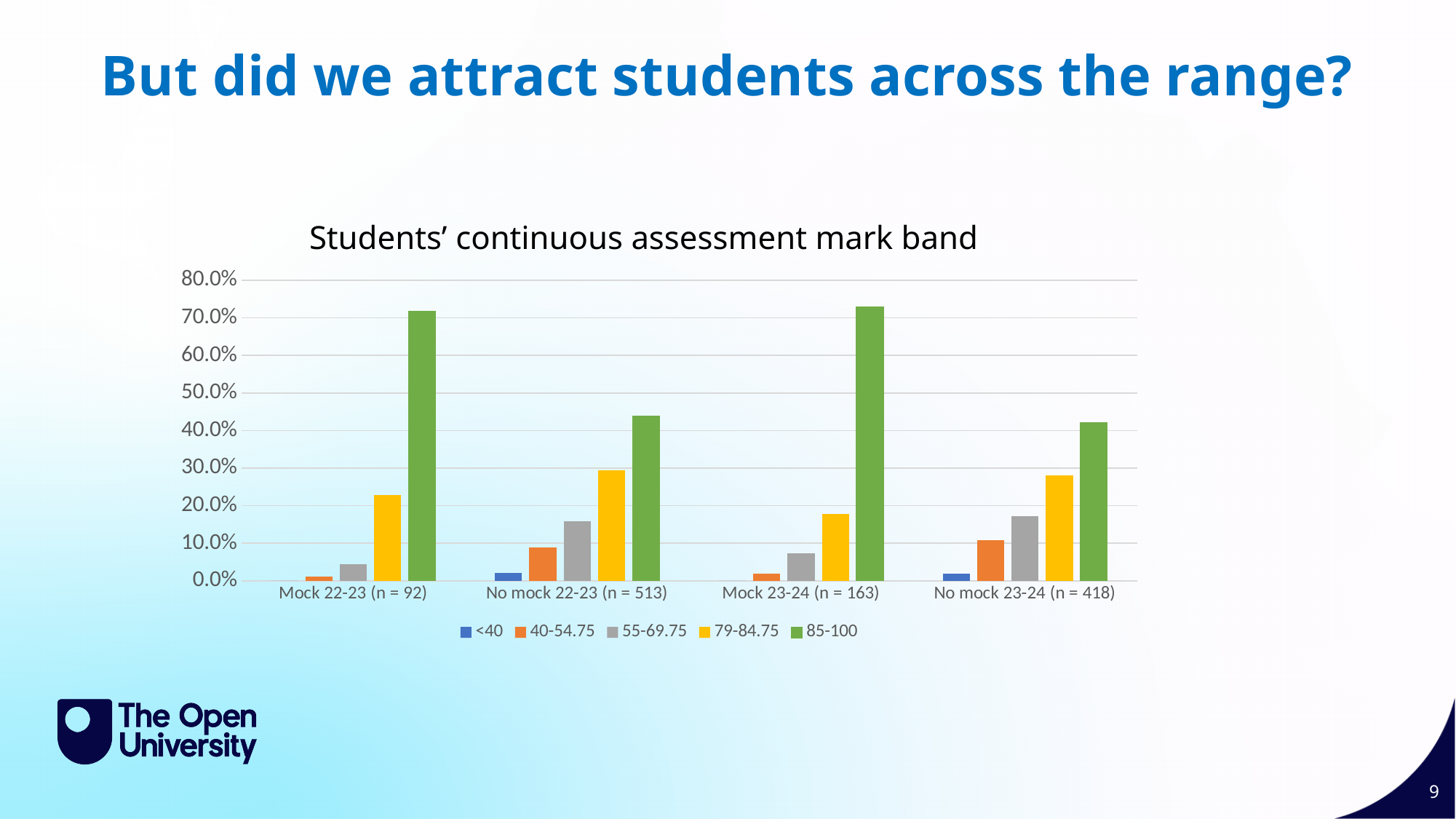
Is the value for 85-100 in Mock 22-23 (n = 92) greater or less than 70.0%? greater What is the title of the chart? Students' continuous assessment mark band Is the value for 55-69.75 in Mock 23-24 (n = 163) greater or less than 10.0%? less Which is larger: the 79-84.75 value for Mock 22-23 (n = 92) or for Mock 23-24 (n = 163)? Mock 22-23 (n = 92) Is the value for 79-84.75 in Mock 22-23 (n = 92) greater or less than 20.0%? greater How many series does the legend list? 5 Which colour represents the 85-100 mark band in the legend? green What kind of chart is shown on the slide? bar chart How many categories are shown on the x axis? 4 Which mark band has the highest value in the Mock 22-23 (n = 92) category? 85-100